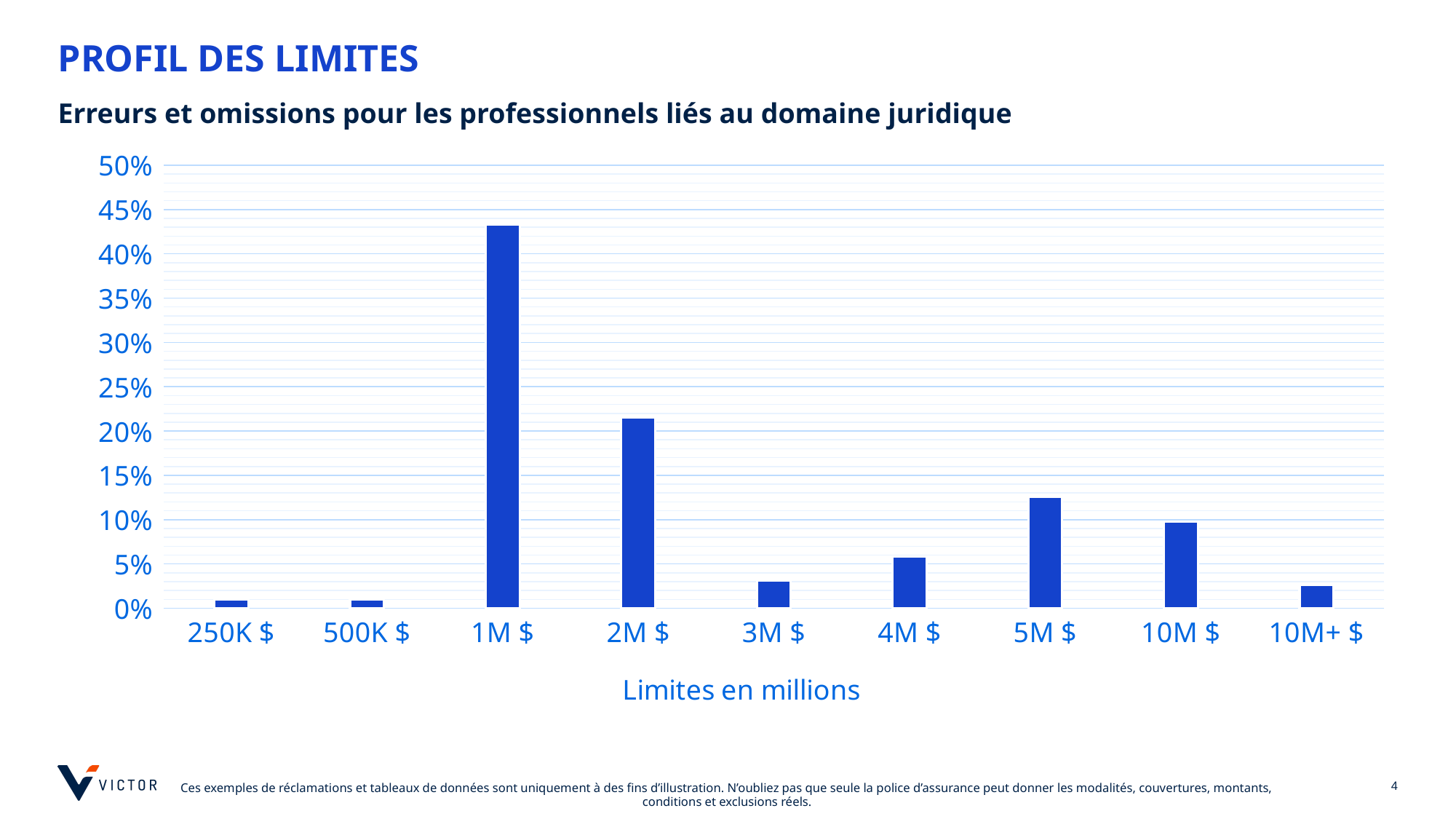
What is the highest value shown on the y axis of the chart? 50% Is the value for 1M $ greater or less than 40%? greater What is the x-axis title of the chart? Limites en millions How many limit categories are shown on the x axis of the chart? 9 Which has a larger value, 3M $ or 4M $? 4M $ Which has a larger value, 5M $ or 10M $? 5M $ Is the value for 2M $ greater or less than 25%? less Which limit category has the highest value in the chart? 1M $ Is the value for 5M $ greater or less than 10%? greater What kind of chart is shown on the slide? Bar chart